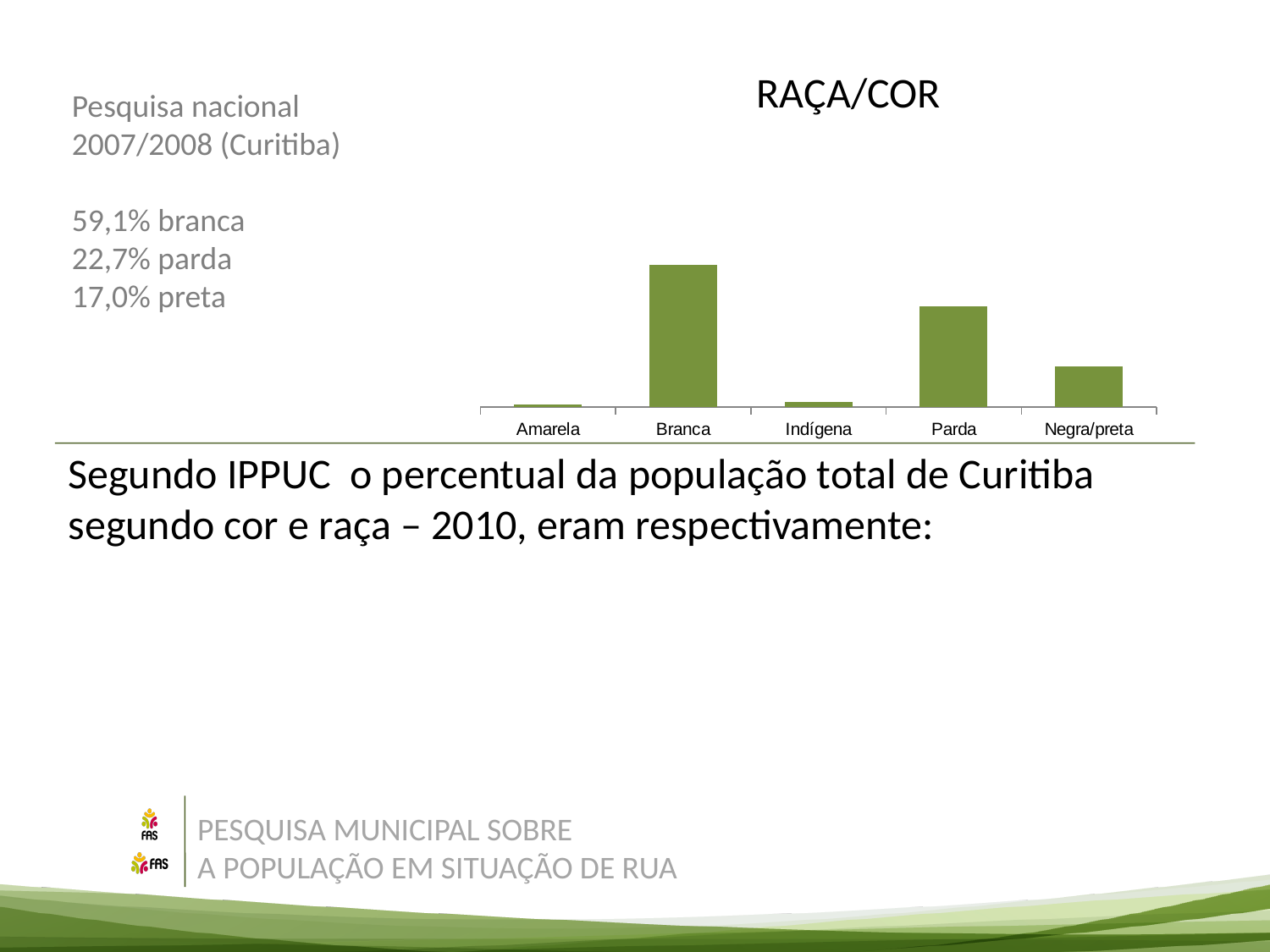
Which bar is taller, Negra/preta or Indígena? Negra/preta What kind of chart is shown on the slide? bar chart Which category has the second highest bar in the chart? Parda What colour are the bars in the chart? green What is the title of the chart? RAÇA/COR Which category has the highest bar in the chart? Branca Which category is the last one on the x axis of the chart? Negra/preta Which bar is taller, Amarela or Branca? Branca Which bar is taller, Branca or Parda? Branca How many categories are shown on the x axis of the chart? 5